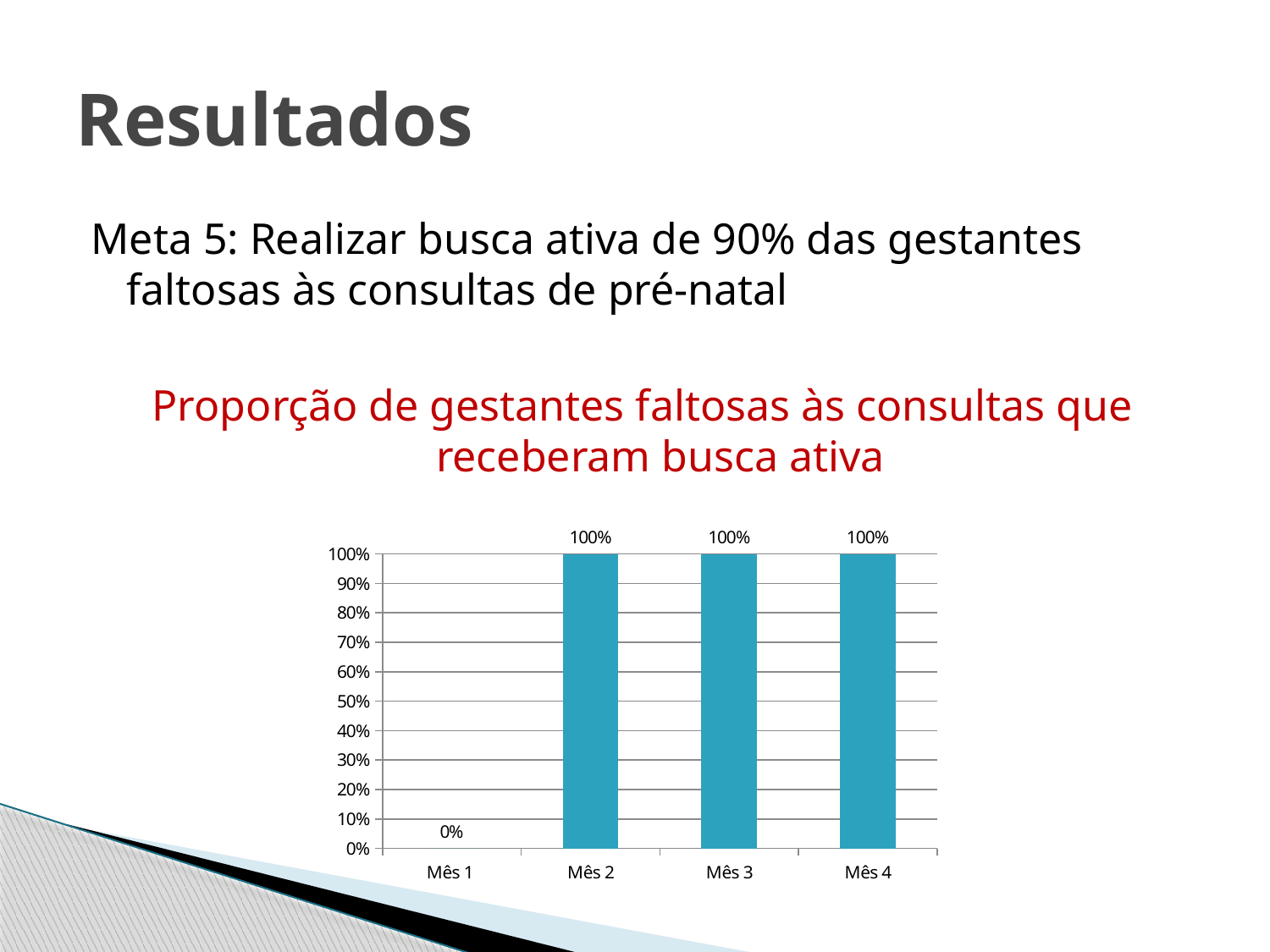
Do the values rise or fall from Mês 1 to Mês 2? Rise What is the highest value shown on the y axis? 100% Is the value for Mês 3 greater or less than 50%? greater What is the difference between the values for Mês 3 and Mês 1? 100% What is the value for Mês 4? 100% What kind of chart is shown on the slide? Bar chart What is the value for Mês 1? 0% How many months are shown on the x axis? 4 What is the title of the chart? Proporção de gestantes faltosas às consultas que receberam busca ativa What is the value for Mês 2? 100% Which month has the lowest value? Mês 1 Which is larger, the value for Mês 1 or the value for Mês 2? Mês 2